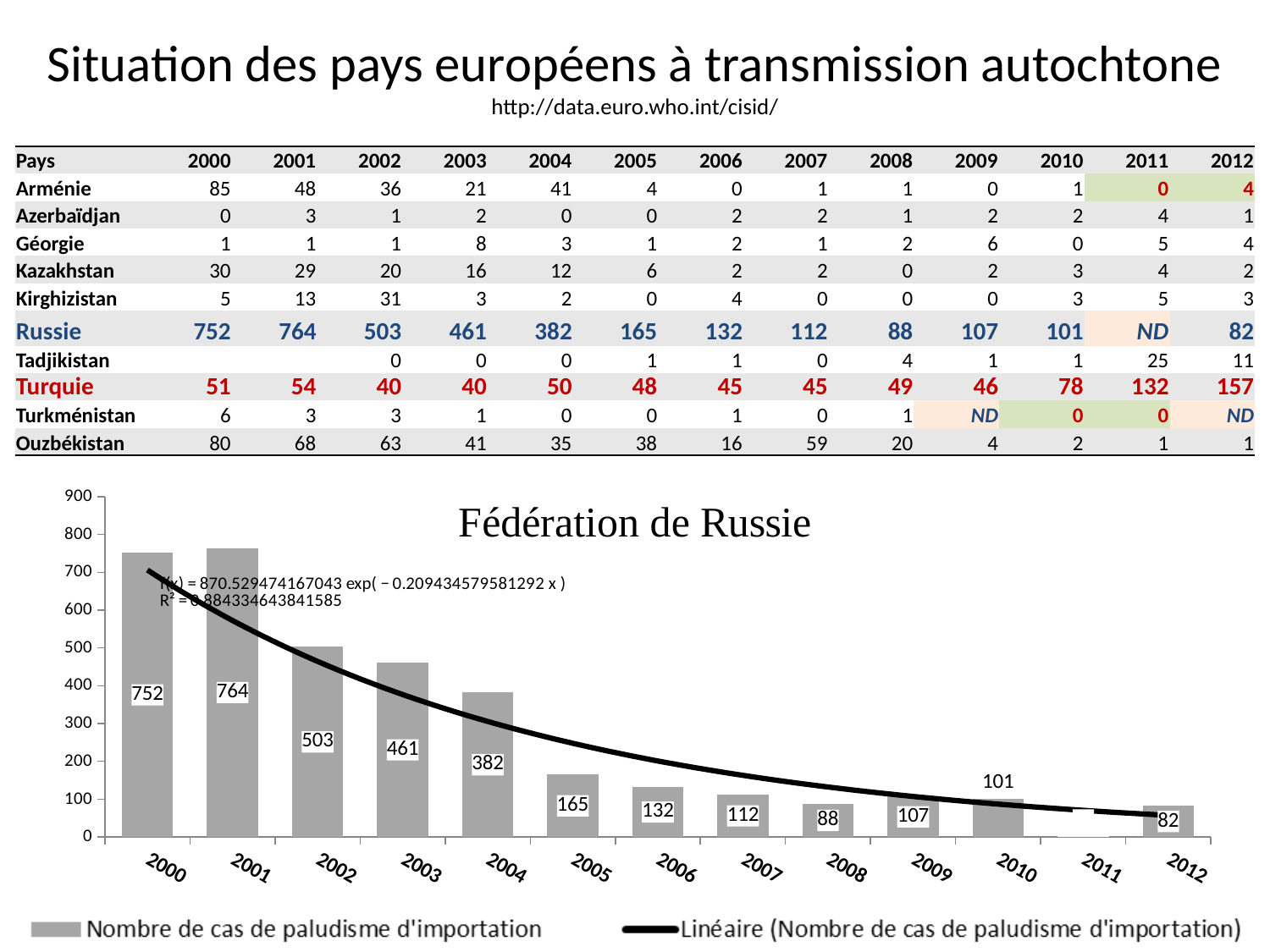
How many entries does the legend of the 'Fédération de Russie' chart list? 2 In the 'Fédération de Russie' chart, what is the value for 2004? 382 In the 'Fédération de Russie' chart, what is the value for 2000? 752 What type of chart is shown under the title 'Fédération de Russie'? bar chart In the 'Fédération de Russie' chart, which is larger, the value for 2009 or the value for 2010? 2009 In the 'Fédération de Russie' chart, which year has the highest value? 2001 In the 'Fédération de Russie' chart, is the value for 2005 greater or less than 200? less In the 'Fédération de Russie' chart, which year with a plotted bar has the lowest value? 2012 In the 'Fédération de Russie' chart, what is the value for 2012? 82 What is the title of the chart on the slide? Fédération de Russie In the 'Fédération de Russie' chart, what is the difference between the values for 2001 and 2002? 261 In the 'Fédération de Russie' chart, do the bar values generally rise or fall from 2000 to 2012? fall